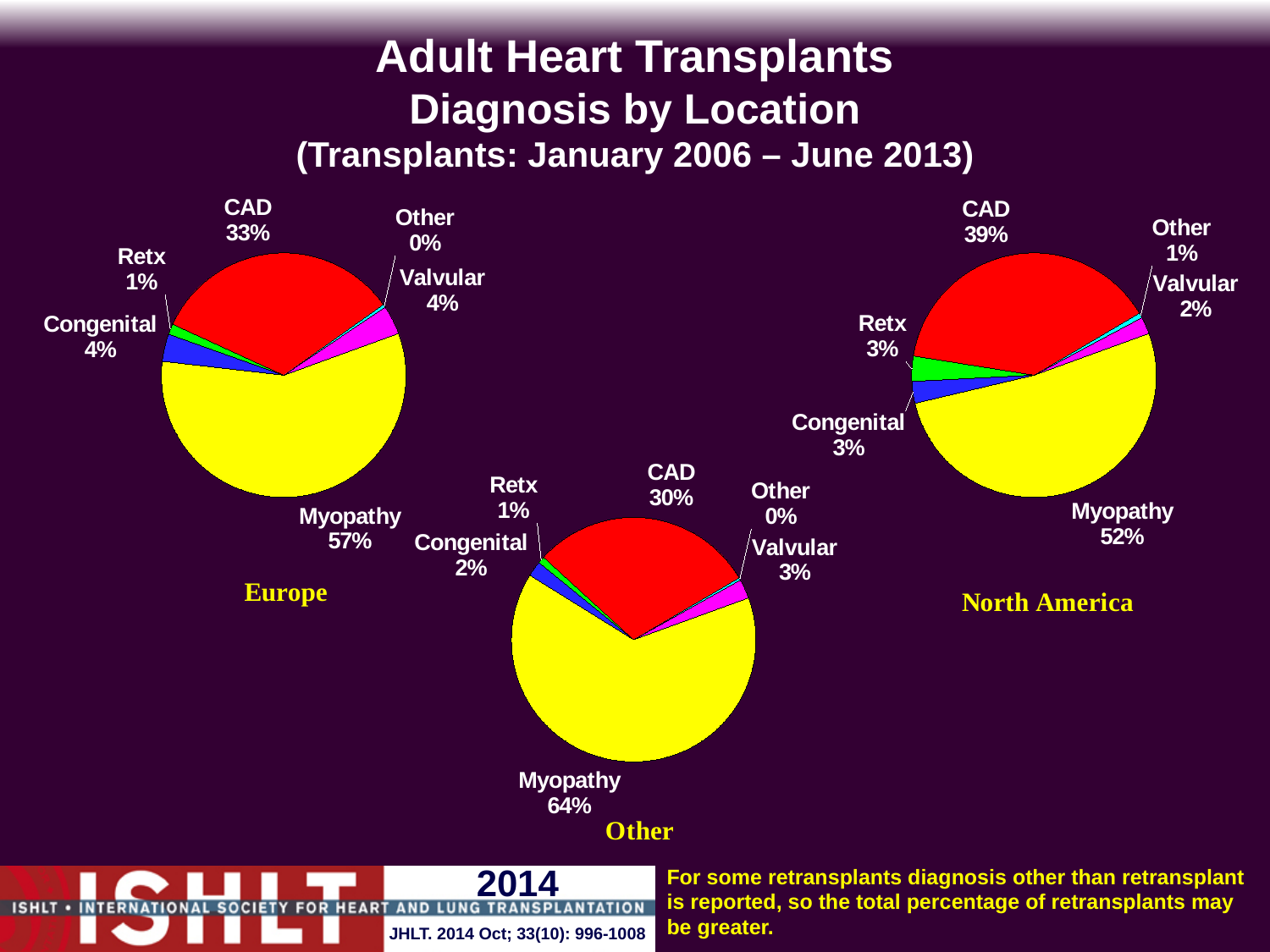
In the Europe pie chart, what percentage is Myopathy? 57% What type of chart is used to show the diagnosis breakdown for each location? Pie chart What is the difference between the Myopathy share in the Other pie chart and the Myopathy share in the North America pie chart? 12% In the Europe pie chart, what is the difference between the CAD share and the Valvular share? 29% In the North America pie chart, what percentage is CAD? 39% How many diagnosis categories are labelled in the North America pie chart? 6 In the North America pie chart, what percentage is Retx? 3% In the Other pie chart, what percentage is Valvular? 3% In the Other pie chart, which diagnosis has the largest share? Myopathy Which is larger: the CAD share in the North America pie chart or the CAD share in the Europe pie chart? North America In the Europe pie chart, which diagnosis has the smallest share? Other How many pie charts are shown on the slide? 3